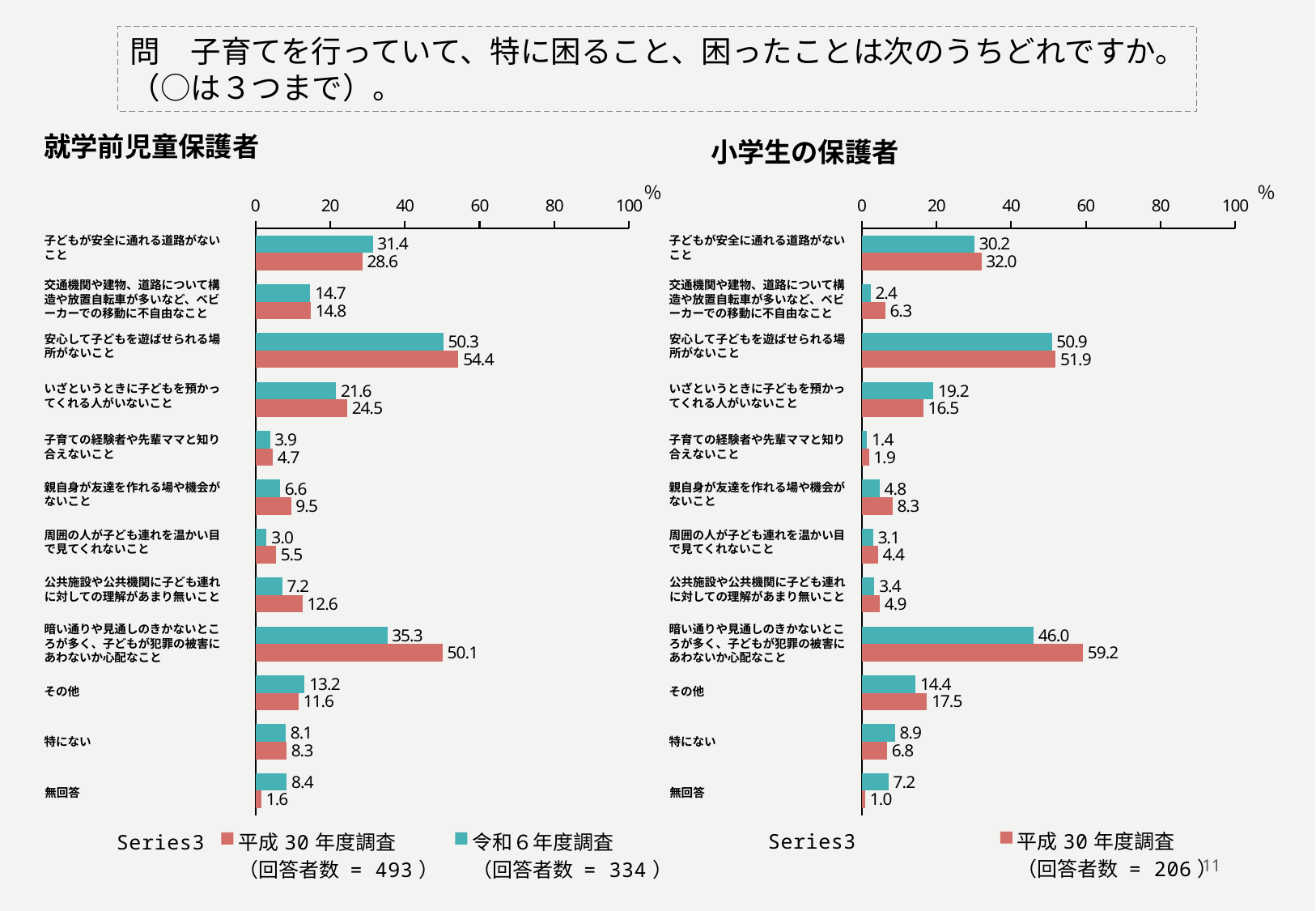
How many categories are shown in the 就学前児童保護者 chart? 12 In the 就学前児童保護者 chart, what is the 令和6年度調査 value for 安心して子どもを遊ばせられる場所がないこと? 50.3 What type of chart is the 小学生の保護者 chart? bar chart In the 小学生の保護者 chart, is the 令和6年度調査 value for 安心して子どもを遊ばせられる場所がないこと greater or less than 40? greater In the 小学生の保護者 chart, which is larger for 子どもが安全に通れる道路がないこと: the 平成30年度調査 value or the 令和6年度調査 value? 平成30年度調査 According to the legend of the 就学前児童保護者 chart, how many respondents were in the 平成30年度調査? 493 In the 就学前児童保護者 chart, what is the 令和6年度調査 value for 無回答? 8.4 In the 就学前児童保護者 chart, which category has the highest 平成30年度調査 value? 安心して子どもを遊ばせられる場所がないこと In the 就学前児童保護者 chart, what is the difference between the 平成30年度調査 and 令和6年度調査 values for 暗い通りや見通しのきかないところが多く、子どもが犯罪の被害にあわないか心配なこと? 14.8 In the 小学生の保護者 chart, what is the 平成30年度調査 value for 暗い通りや見通しのきかないところが多く、子どもが犯罪の被害にあわないか心配なこと? 59.2 In the 小学生の保護者 chart, what is the difference between the 平成30年度調査 and 令和6年度調査 values for 交通機関や建物、道路について構造や放置自転車が多いなど、ベビーカーでの移動に不自由なこと? 3.9 In the 小学生の保護者 chart, which category has the lowest 平成30年度調査 value? 無回答